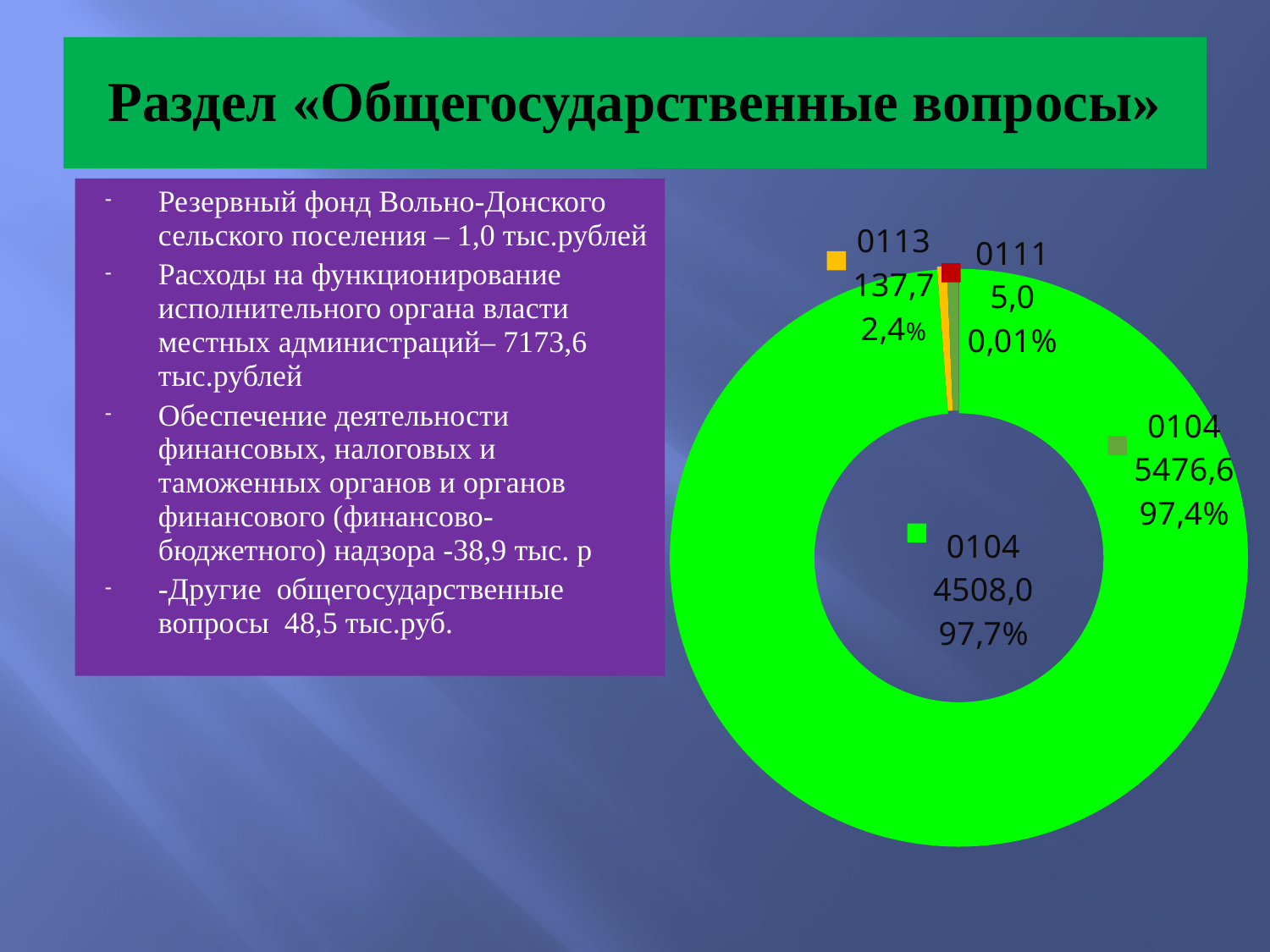
What value is shown for category 0111 in the chart? 5,0 Which category has the smallest slice in the chart? 0111 What is the difference between the values for 0113 and 0111? 132,7 Which is larger, the value for 0113 or the value for 0111? 0113 Which category has the largest slice in the chart? 0104 What percentage share is labelled for category 0111? 0,01% What value is shown for category 0113 in the chart? 137,7 What percentage share is labelled for category 0113? 2,4% What kind of chart is shown on the slide? doughnut (pie) chart What value is labelled for 0104 inside the ring of the chart? 4508,0 What percentage is labelled next to the outer 0104 value of 5476,6? 97,4% What colour is the slice for category 0113? yellow